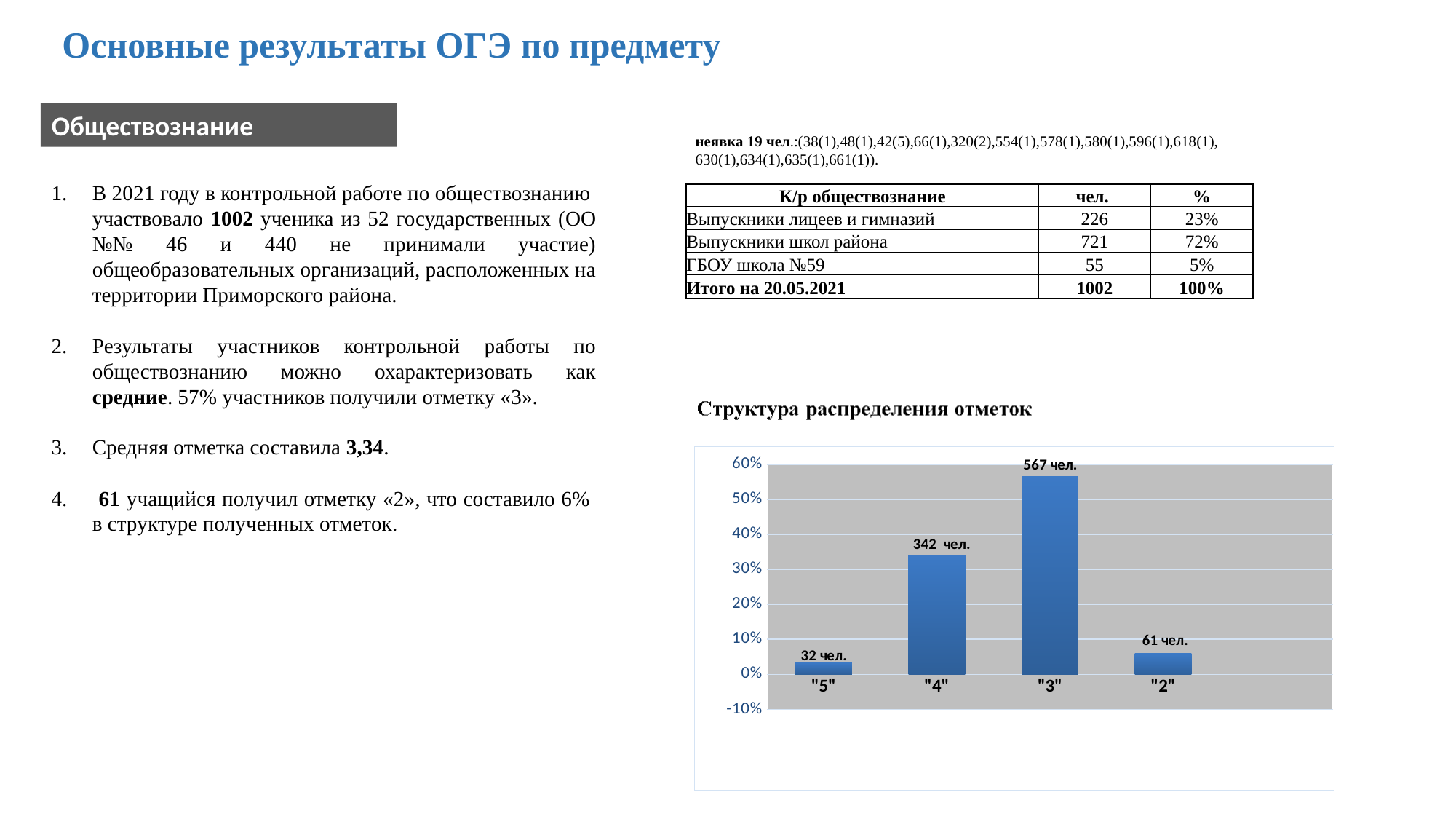
Which grade category has the tallest bar in the chart? "3" How many more students are labelled on the bar for grade "3" than on the bar for grade "4"? 225 What is the data label on the bar for grade "2"? 61 чел. Is the bar for grade "3" greater or less than 50% on the y axis? greater What kind of chart is shown under the title "Структура распределения отметок"? bar chart What is the data label on the bar for grade "4"? 342 чел. What is the data label on the bar for grade "3"? 567 чел. What is the data label on the bar for grade "5"? 32 чел. Is the bar for grade "5" greater or less than 10% on the y axis? less How many grade categories are shown on the x axis of the chart? 4 Which grade category has the shortest bar in the chart? "5" Which bar is taller: grade "2" or grade "5"? "2"